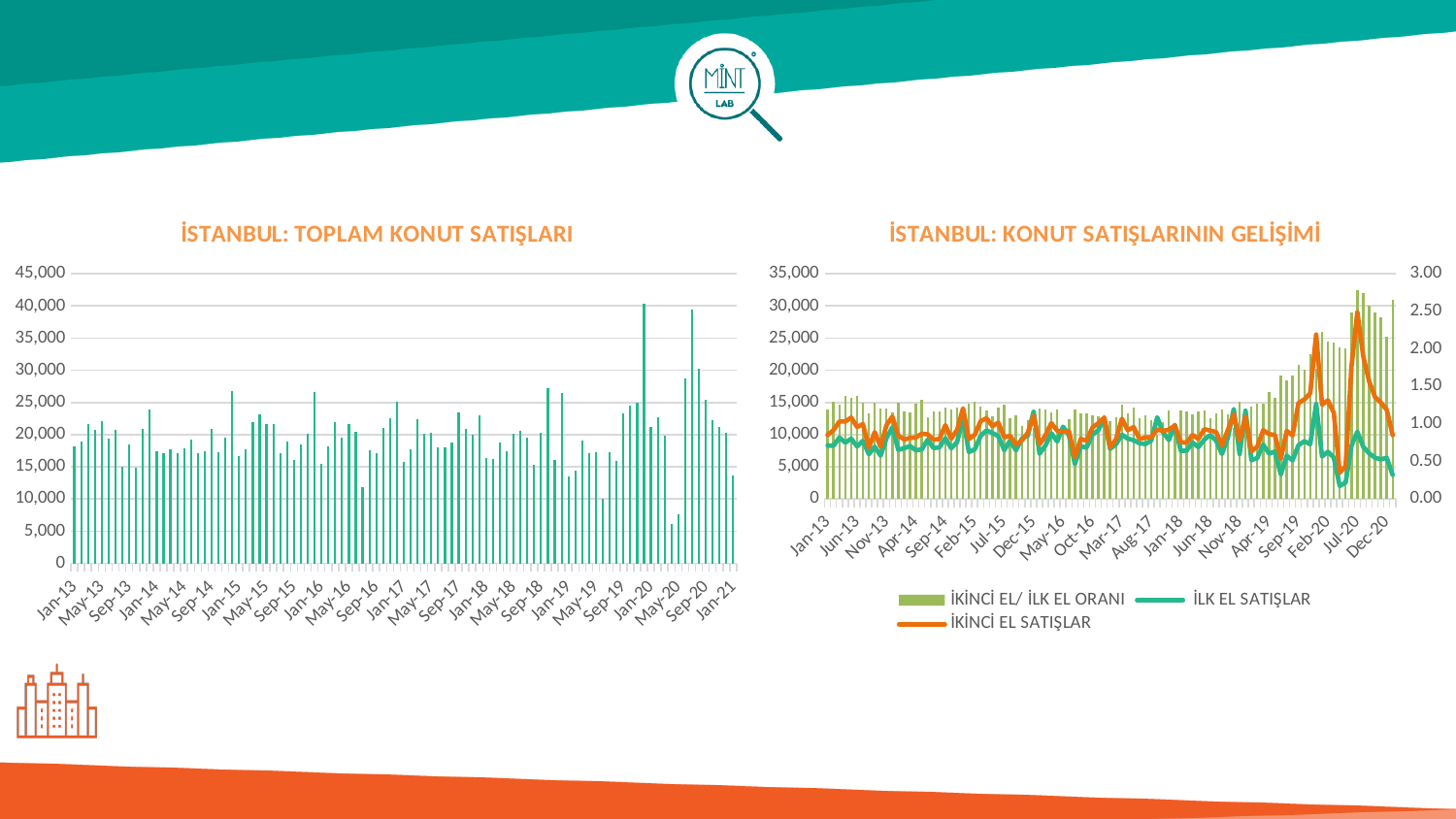
What is the highest value shown on the vertical axis of the 'İSTANBUL: TOPLAM KONUT SATIŞLARI' chart? 45,000 In the 'İSTANBUL: KONUT SATIŞLARININ GELİŞİMİ' chart, is the İKİNCİ EL/ İLK EL ORANI value for Jul-20 greater or less than 2.00? greater How many series does the legend of the 'İSTANBUL: KONUT SATIŞLARININ GELİŞİMİ' chart list? 3 In the 'İSTANBUL: KONUT SATIŞLARININ GELİŞİMİ' chart, which series is higher at Dec-20, İLK EL SATIŞLAR or İKİNCİ EL SATIŞLAR? İKİNCİ EL SATIŞLAR In the 'İSTANBUL: KONUT SATIŞLARININ GELİŞİMİ' chart, which series is drawn as bars? İKİNCİ EL/ İLK EL ORANI What kind of chart is the 'İSTANBUL: TOPLAM KONUT SATIŞLARI' chart? Bar chart In the 'İSTANBUL: KONUT SATIŞLARININ GELİŞİMİ' chart, does the İKİNCİ EL/ İLK EL ORANI series generally rise or fall from Jan-18 to Jul-20? Rise In the 'İSTANBUL: TOPLAM KONUT SATIŞLARI' chart, is the value for Jan-21 greater or less than 20,000? less In the 'İSTANBUL: KONUT SATIŞLARININ GELİŞİMİ' chart, what colour is the İKİNCİ EL SATIŞLAR line? Orange In the 'İSTANBUL: KONUT SATIŞLARININ GELİŞİMİ' chart, is the İLK EL SATIŞLAR value for Dec-20 greater or less than 10,000? less